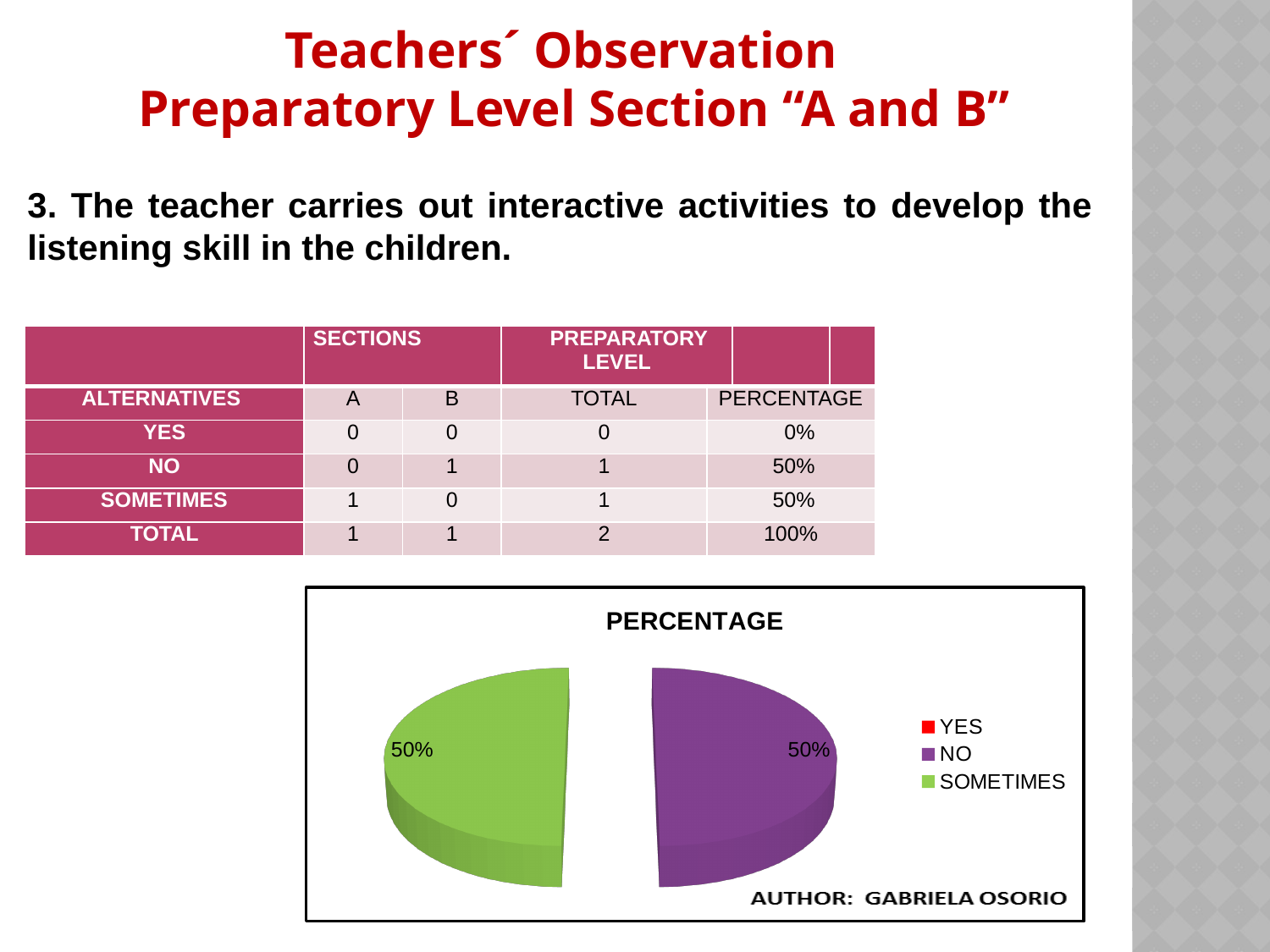
What is the title of the chart? PERCENTAGE What is the value shown for the YES category in the chart? 0% What is the difference between the NO and SOMETIMES slices? 0% How many entries does the chart legend list? 3 What share of the pie does the SOMETIMES slice represent? 50% Is the value for NO greater or less than the value for YES? greater What kind of chart is shown on the slide? pie chart What is the total of the NO and SOMETIMES slices combined? 100% What share of the pie does the NO slice represent? 50% What colour is the SOMETIMES slice in the chart? green Which category has the lowest value in the chart? YES How many slices are visible in the pie chart? 2